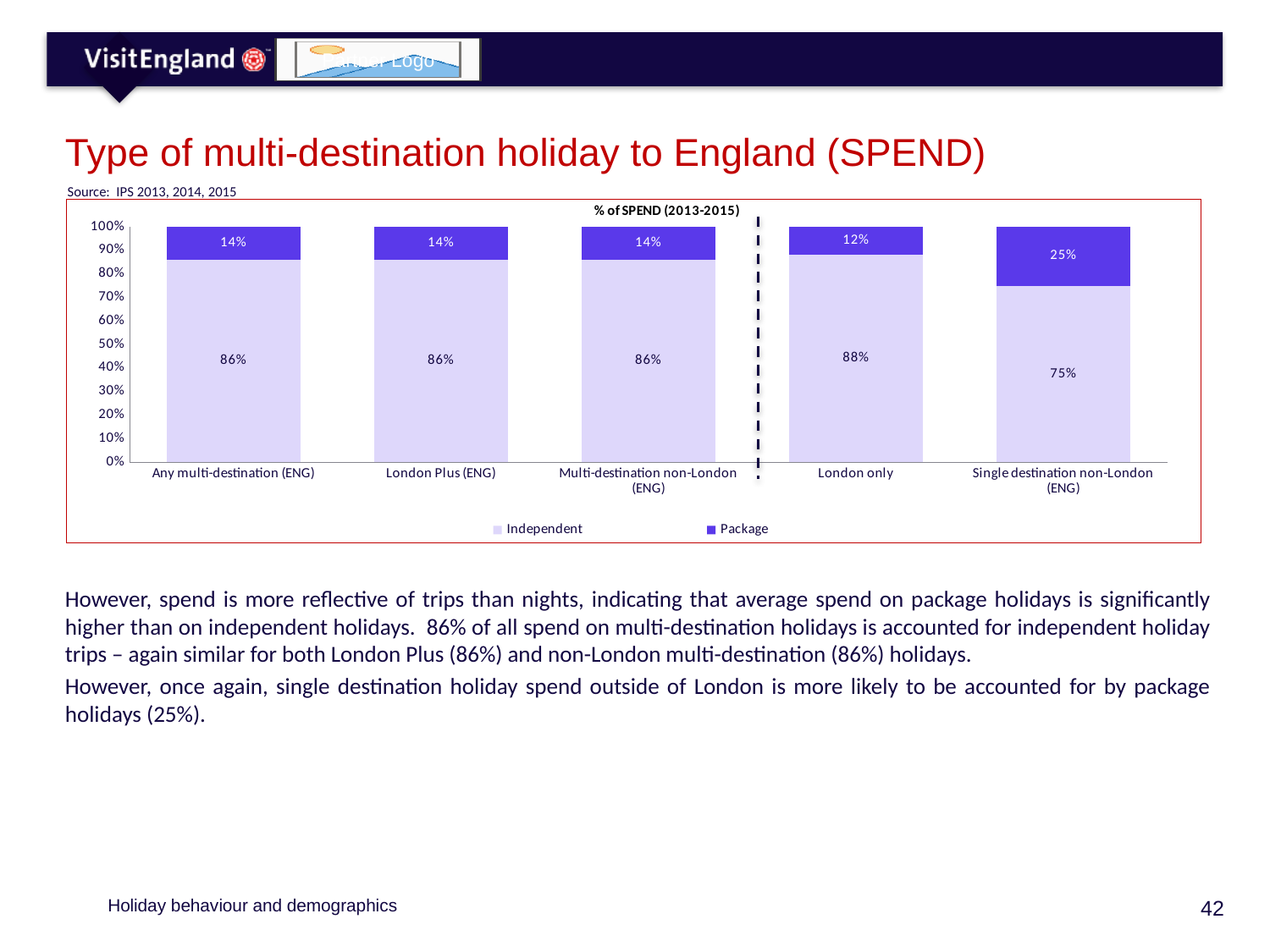
What is the Package share of spend for Single destination non-London (ENG)? 25% What is the Independent share of spend for London only? 88% What kind of chart is shown? Stacked bar chart What is the difference between the Independent share for London only and for Single destination non-London (ENG)? 13% Which category has the lowest Package share of spend? London only What is the title of the chart? % of SPEND (2013-2015) Is the Package share larger for London only or for Single destination non-London (ENG)? Single destination non-London (ENG) How many categories are shown on the x axis? 5 How many series does the legend list? 2 What is the Package share of spend for London Plus (ENG)? 14% Which category has the highest Package share of spend? Single destination non-London (ENG) What is the Independent share of spend for Multi-destination non-London (ENG)? 86%